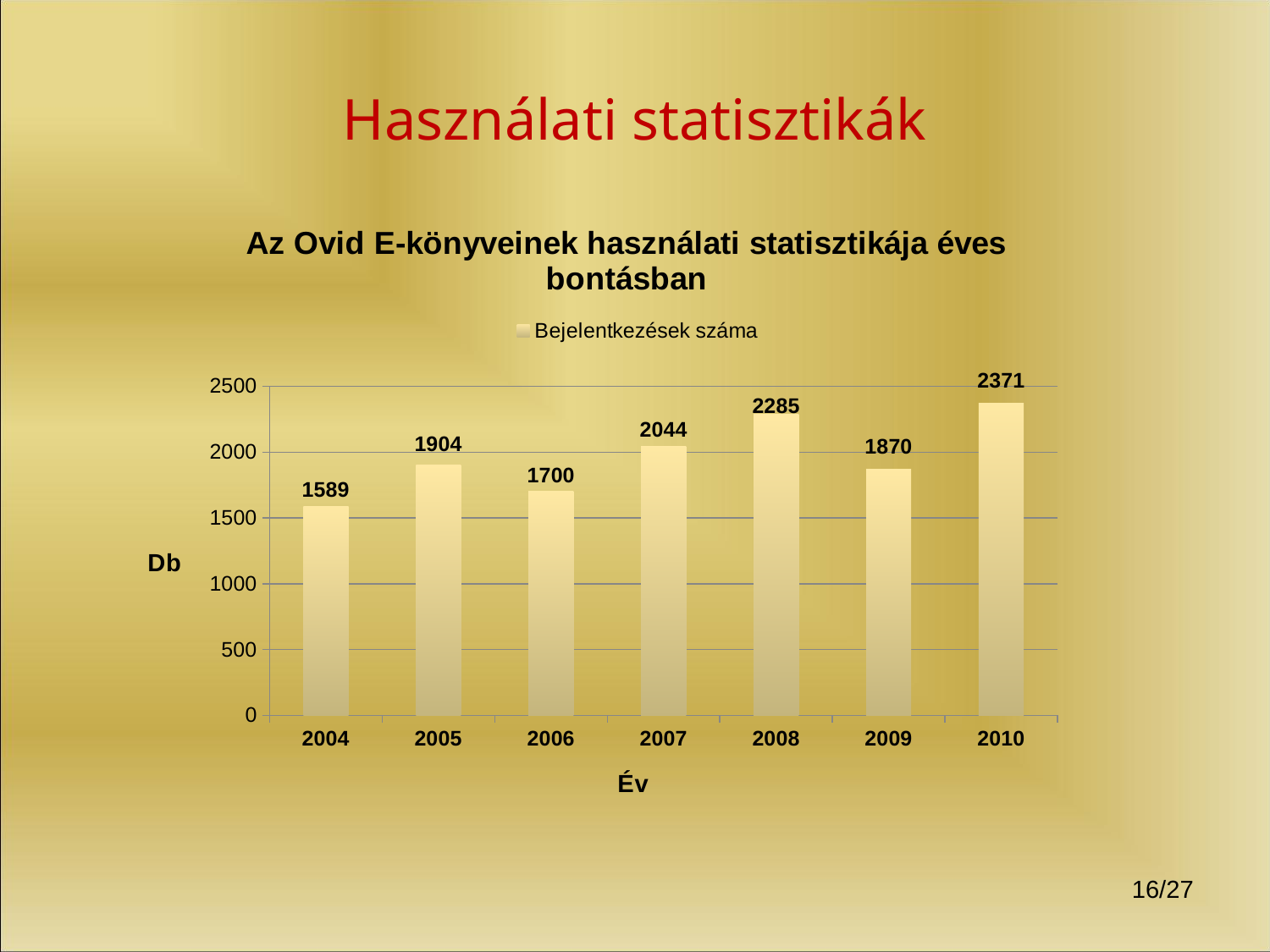
Which year has the lowest value? 2004 What is the value for 2006? 1700 Which year has the highest value? 2010 How many years are shown on the x axis? 7 Which is larger, the value for 2007 or the value for 2009? 2007 What is the series name shown in the legend? Bejelentkezések száma What is the value for 2008? 2285 What kind of chart is shown? bar chart Is the value for 2008 greater or less than 2000? greater What is the difference between the values for 2005 and 2004? 315 What is the value for 2004? 1589 What is the difference between the values for 2010 and 2009? 501